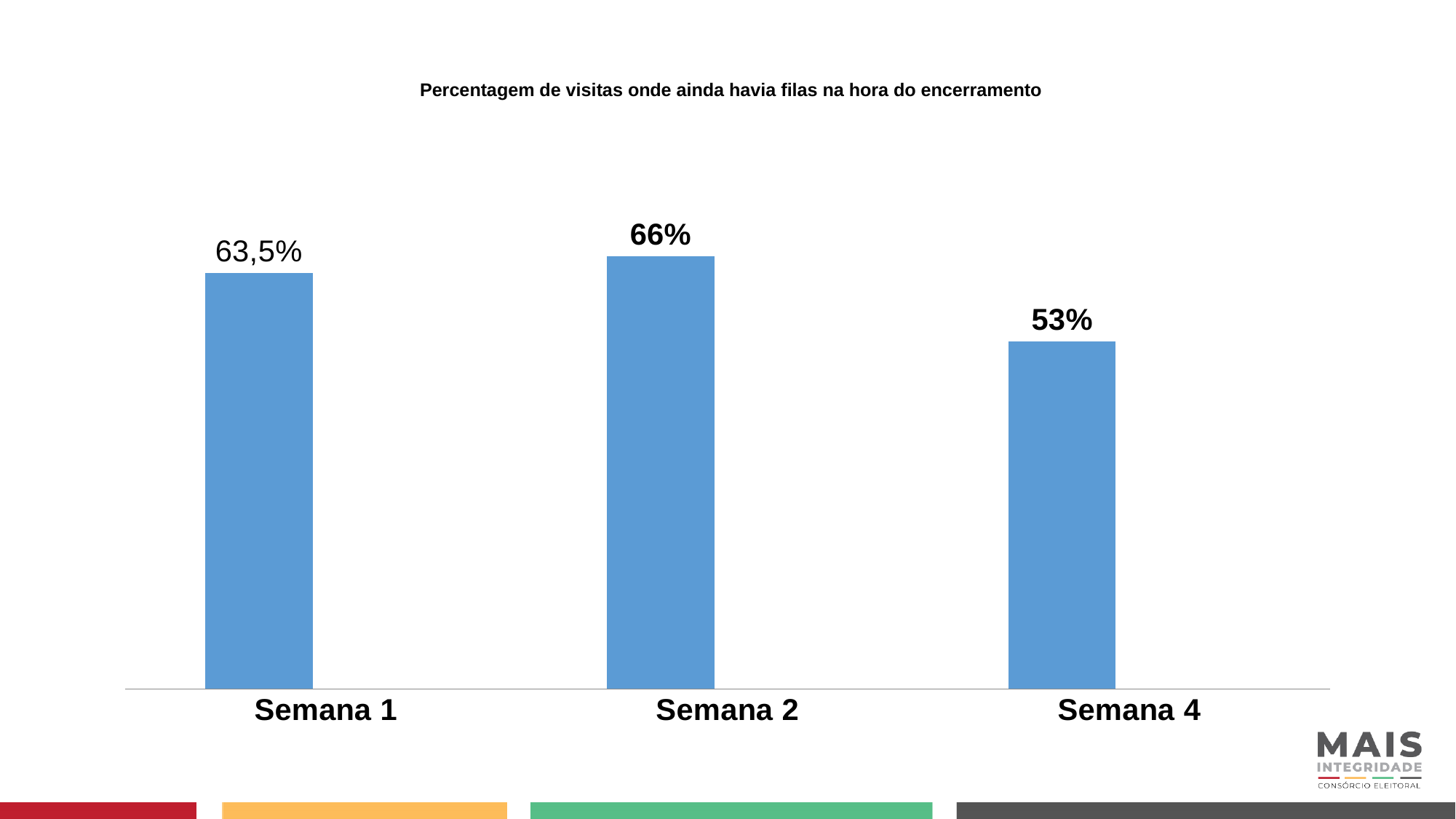
Which category has the highest value? Semana 2 What is the value for Semana 2? 66% What is the difference between the values for Semana 2 and Semana 1? 2,5% Do the values rise or fall from Semana 2 to Semana 4? Fall How many categories are shown on the x axis? 3 What is the difference between the values for Semana 2 and Semana 4? 13% Which is larger, the value for Semana 1 or the value for Semana 4? Semana 1 Which category has the lowest value? Semana 4 What is the value for Semana 1? 63,5% What is the value for Semana 4? 53% What is the title of the chart? Percentagem de visitas onde ainda havia filas na hora do encerramento What kind of chart is this? Bar chart